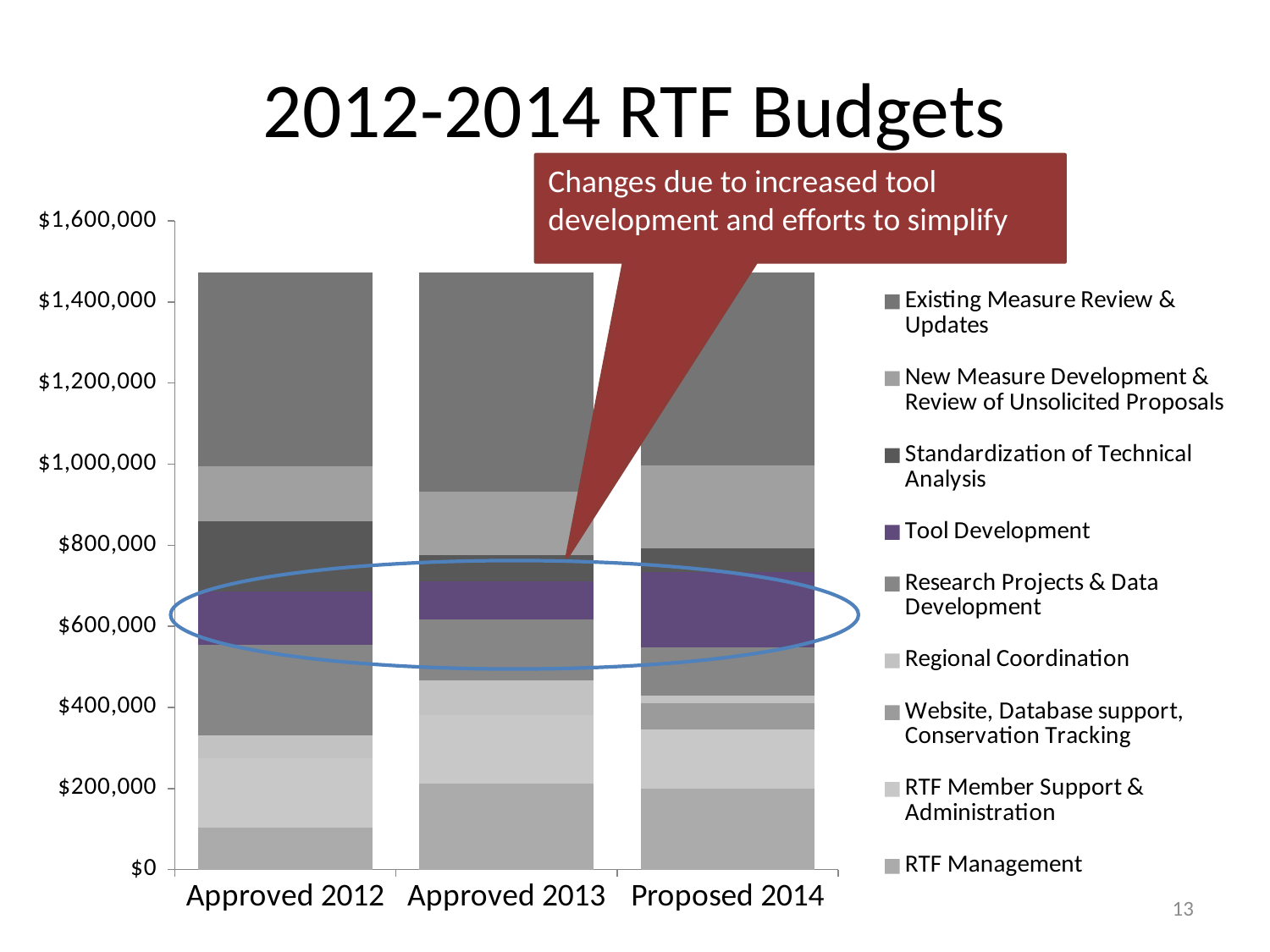
What is the title of the chart? 2012-2014 RTF Budgets What kind of chart is shown on the slide? Stacked bar chart Is the RTF Management amount for Approved 2012 greater or less than $200,000? less Is the total budget for Approved 2012 greater or less than $1,400,000? greater Which series is drawn in purple? Tool Development How many budget years (categories) are shown on the x axis? 3 Is the Tool Development segment larger for Proposed 2014 or Approved 2013? Proposed 2014 Which year has the largest Tool Development segment? Proposed 2014 Is the total budget for Proposed 2014 greater or less than $1,600,000? less Is the RTF Member Support & Administration segment larger for Approved 2012 or Proposed 2014? Approved 2012 Which year has the largest Standardization of Technical Analysis segment? Approved 2012 How many series does the legend list? 9